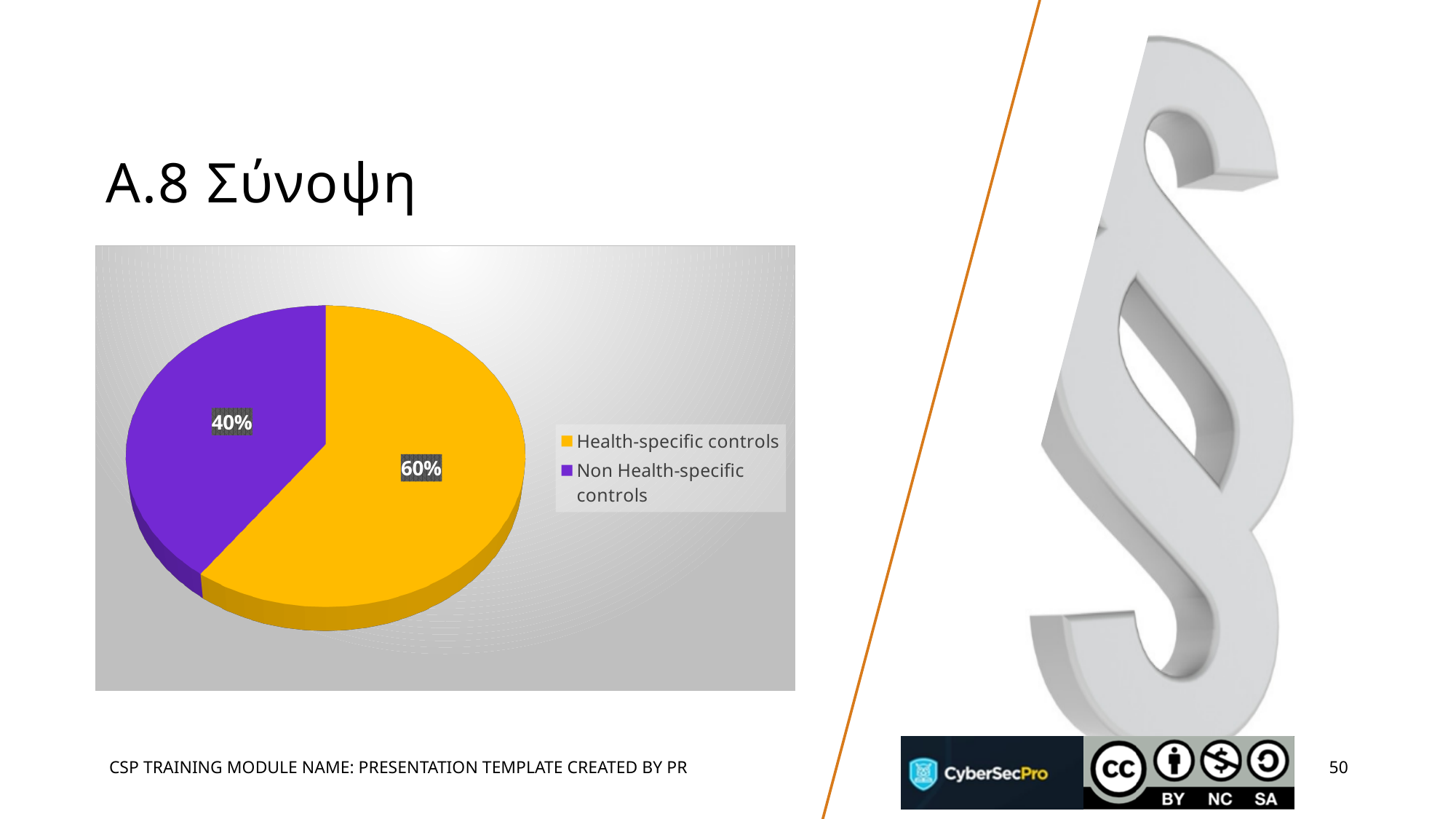
What kind of chart is shown on the slide? pie chart Which is larger: Health-specific controls or Non Health-specific controls? Health-specific controls What share of the pie is Health-specific controls? 60% Which slice of the pie is the largest? Health-specific controls What colour is the Non Health-specific controls slice? purple What share of the pie is Non Health-specific controls? 40% How many slices does the pie chart have? 2 What colour is the Health-specific controls slice? yellow How many entries does the legend list? 2 Which slice of the pie is the smallest? Non Health-specific controls What is the difference in percentage points between Health-specific controls and Non Health-specific controls? 20 percentage points